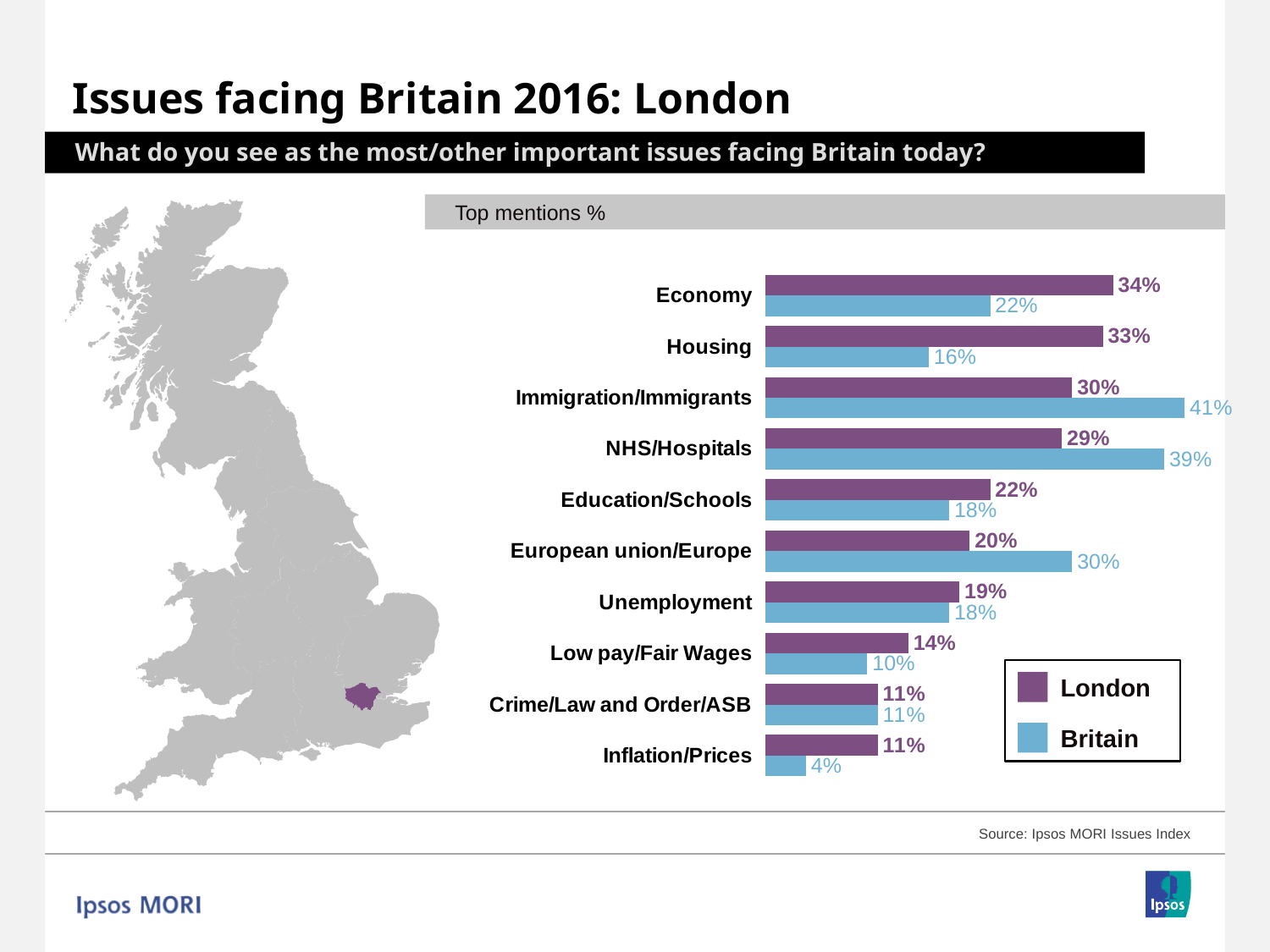
Which issue has the highest London value? Economy How many issues are listed in the chart? 10 What percentage of London respondents mentioned Housing as an important issue? 33% For European union/Europe, which is larger: the London value or the Britain value? Britain What is the difference between the London and Britain values for Housing? 17 percentage points What is the Britain value for Immigration/Immigrants? 41% How many series does the legend list? 2 Which colour represents London in the chart? Purple Which issue has the lowest Britain value? Inflation/Prices What is the London value for Inflation/Prices? 11% What is the difference between the Britain and London values for NHS/Hospitals? 10 percentage points What type of chart is shown on the slide? Bar chart